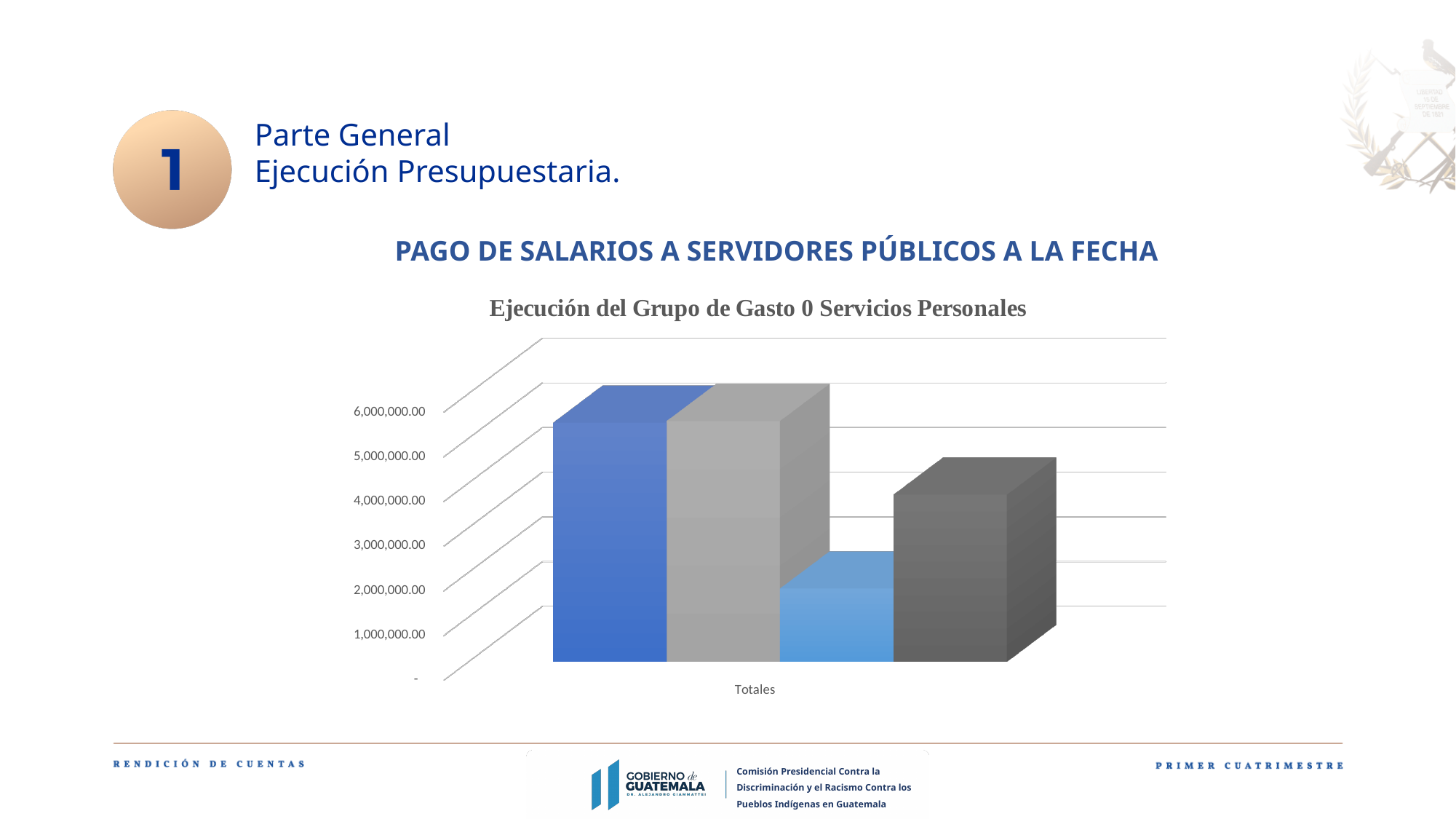
Is the value of the dark gray bar greater or less than 3,000,000.00? greater How many bars are plotted in the chart? 4 Which bar is the lowest in the chart? the light blue bar What is the title of the chart? Ejecución del Grupo de Gasto 0 Servicios Personales What kind of chart is shown on the slide? bar chart Is the value of the light blue bar greater or less than 3,000,000.00? less Which is larger, the dark gray bar or the light blue bar? the dark gray bar What is the highest value labelled on the y axis of the chart? 6,000,000.00 Which is larger, the dark blue bar or the light blue bar? the dark blue bar Is the value of the dark gray bar greater or less than 5,000,000.00? less What is the only category label shown on the x axis of the chart? Totales